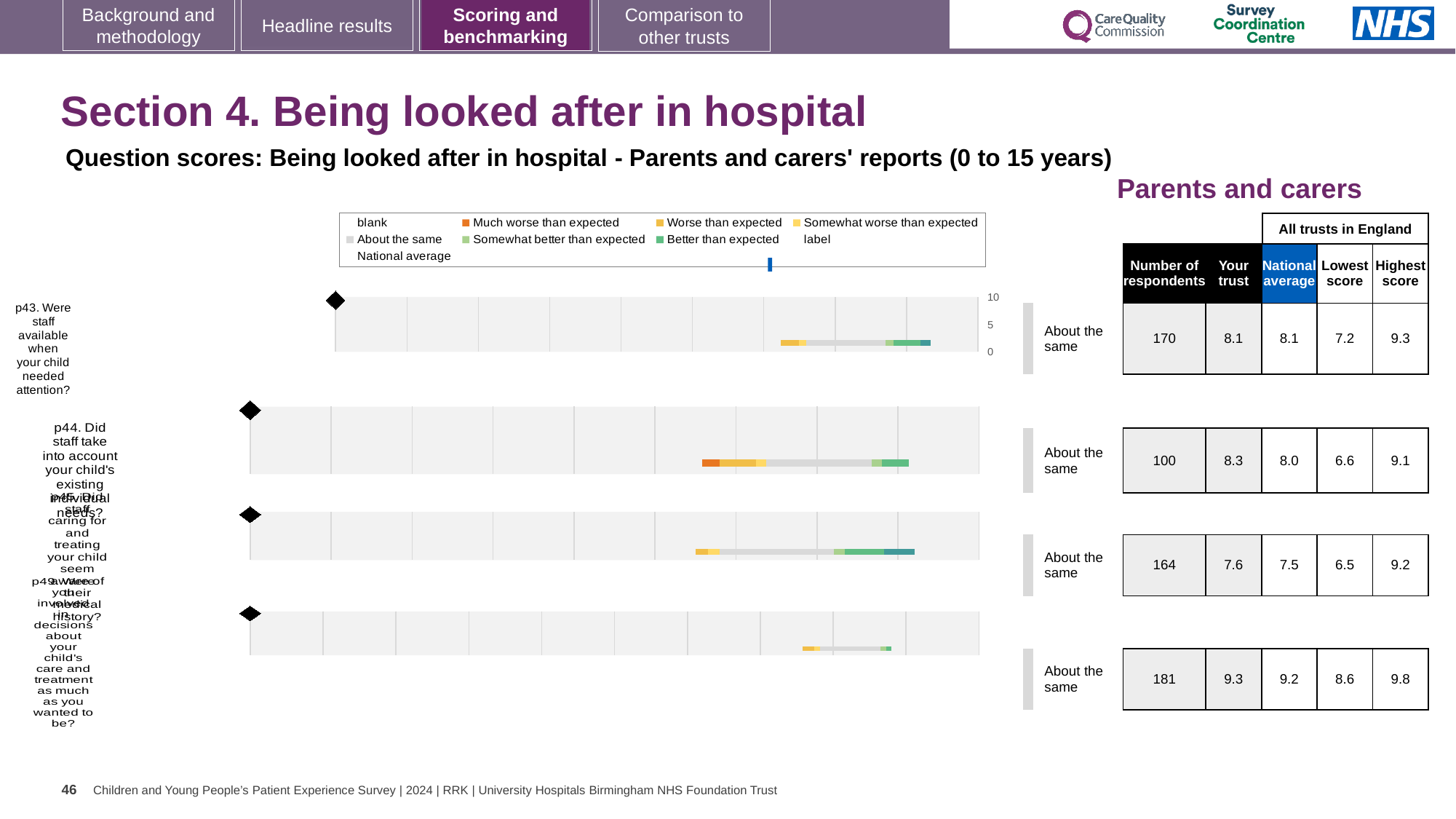
How many questions (p43, p44, p45, p49) are plotted as separate bars on this slide? 4 What is the national average shown for question p44 (Did staff take into account your child's existing individual needs?)? 8.0 Which of the four questions has the highest 'Your trust' score? p49 For question p45, which is larger: the 'Your trust' score or the national average? Your trust What is the highest score across all trusts in England shown for question p49? 9.8 What is the 'Your trust' score shown for question p43 (Were staff available when your child needed attention?)? 8.1 How many respondents are shown for question p45? 164 What colour does the legend use for 'Much worse than expected'? orange Which of the four questions has the lowest 'Your trust' score? p45 What kind of chart is used to show the question scores on this slide? bar chart What is the difference between the 'Your trust' score and the national average for question p44? 0.3 What benchmark category is shown for question p43? About the same